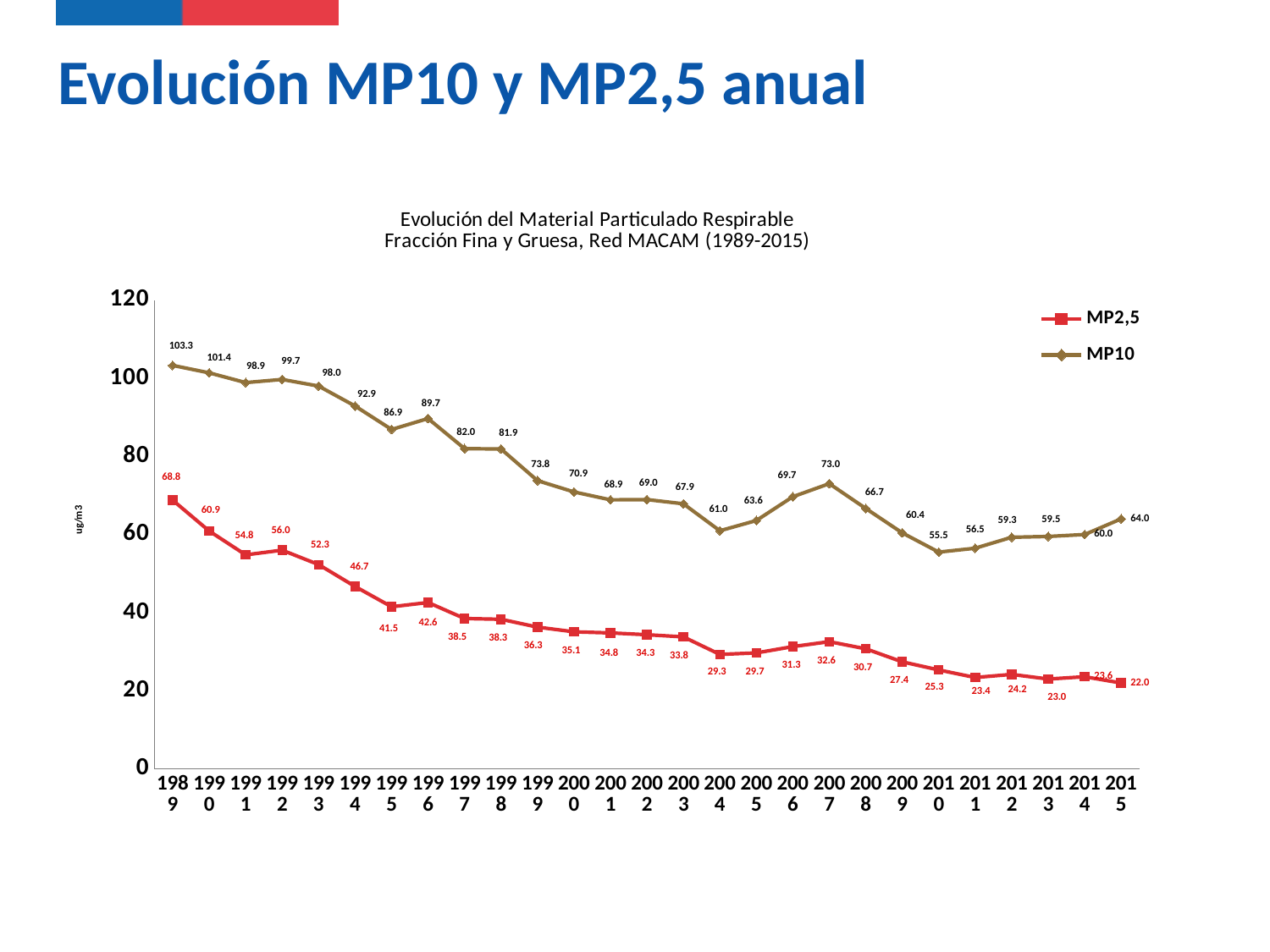
In which year is the MP2,5 value lowest? 2015 What kind of chart is shown on the slide? Line chart What is the MP10 value for 2007? 73.0 Which is larger, the MP2,5 value in 2006 or in 2009? 2006 Overall, do the MP10 values rise or fall from 1989 to 2015? Fall How many years are plotted on the x axis? 27 How many series does the legend list? 2 What is the MP2,5 value for 2015? 22.0 What is the MP10 value for 1989? 103.3 What unit is shown on the y axis label? ug/m3 In which year is the MP10 value highest? 1989 What is the difference between the MP10 value in 1989 and in 2015? 39.3